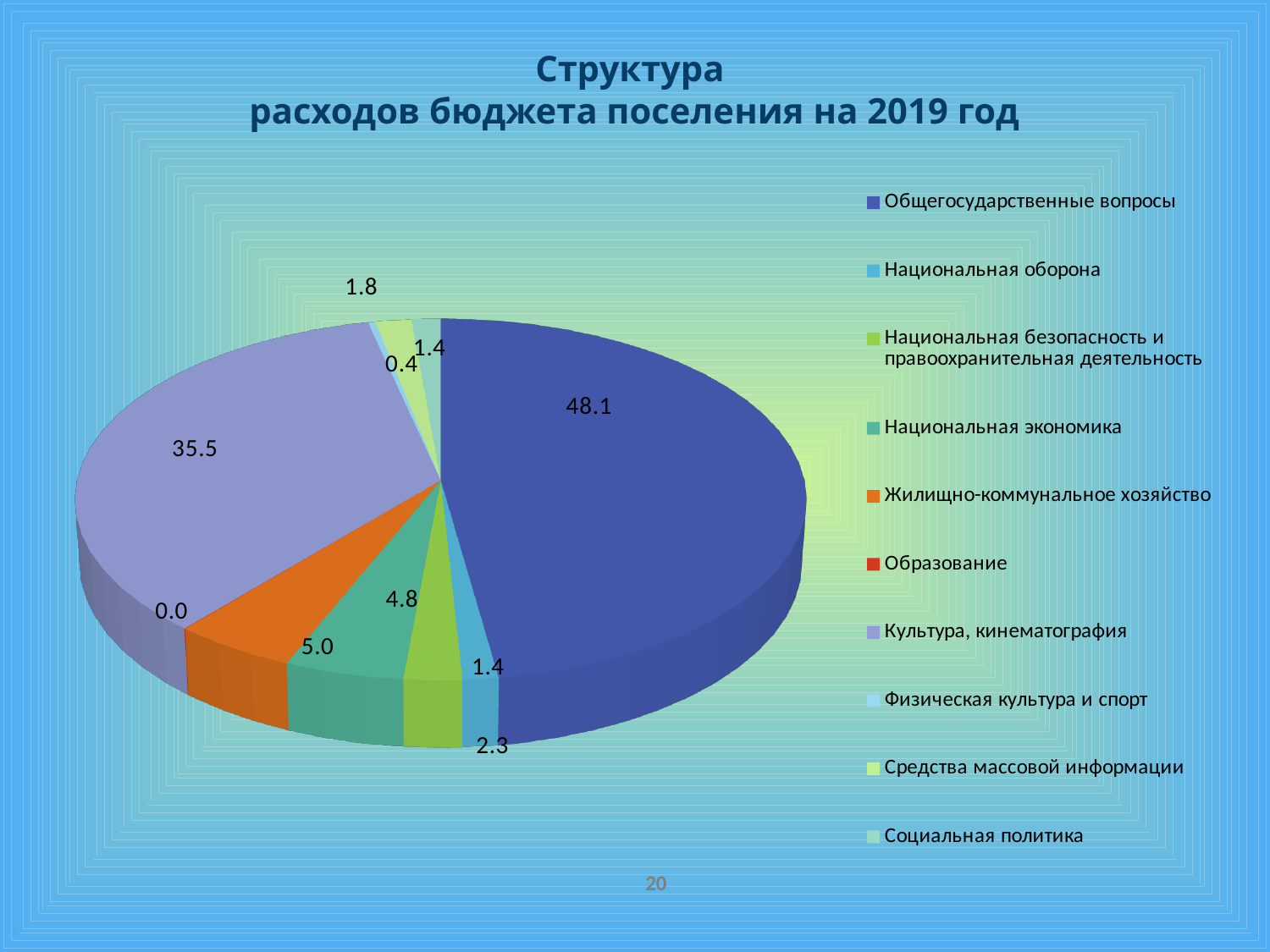
Which is larger: Общегосударственные вопросы or Культура, кинематография? Общегосударственные вопросы What share of the pie does Культура, кинематография take? 35.5 What value is shown for Общегосударственные вопросы? 48.1 What type of chart is shown on the slide? pie chart What colour is the slice for Общегосударственные вопросы? dark blue What value is shown for Образование? 0.0 How many categories does the legend list? 10 What is the difference between the values for Общегосударственные вопросы and Культура, кинематография? 12.6 What is the title of the chart? Структура расходов бюджета поселения на 2019 год What value is shown for Культура, кинематография? 35.5 Which category has the largest slice of the pie? Общегосударственные вопросы